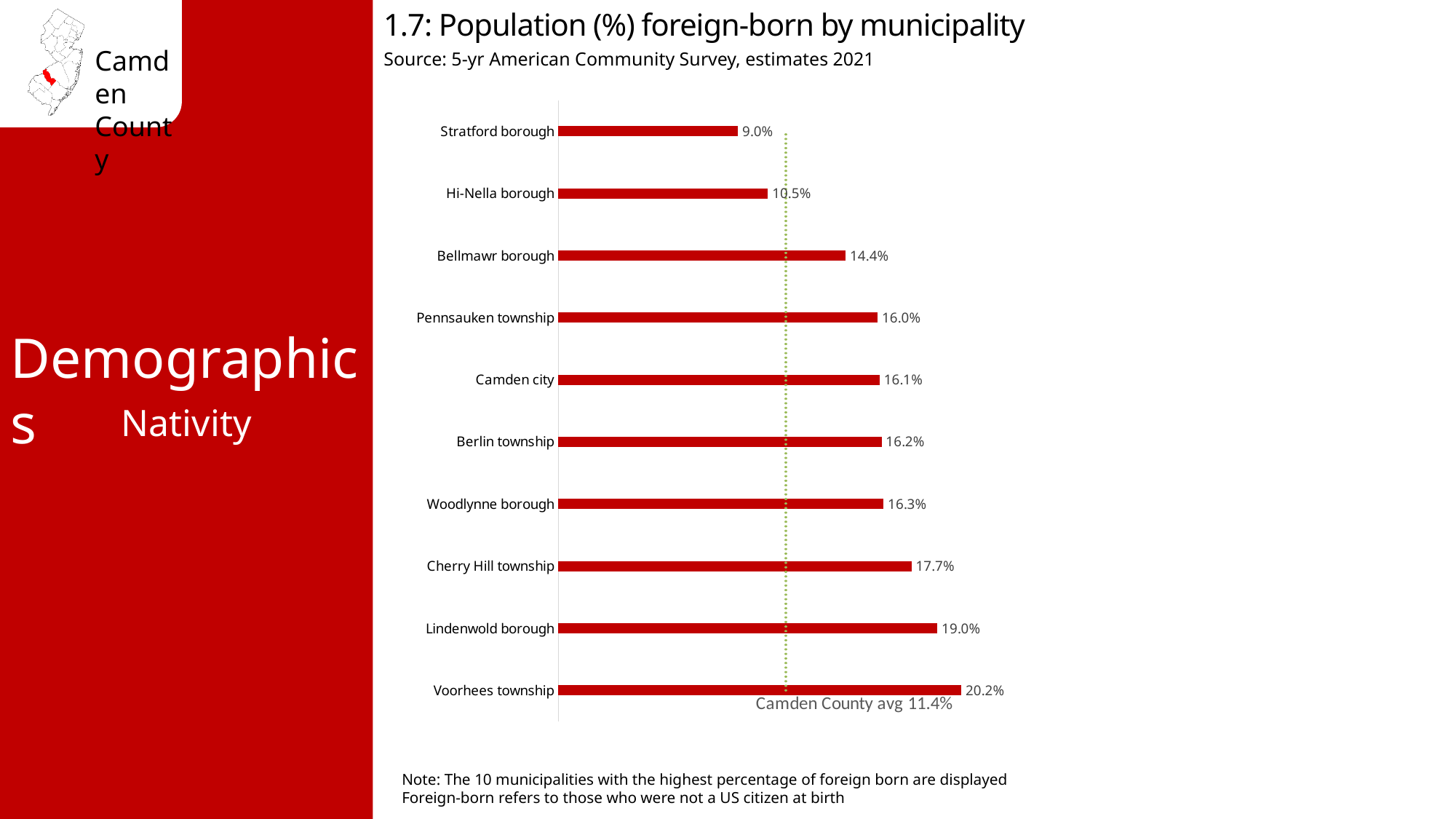
What is the foreign-born population percentage for Voorhees township? 20.2% How many municipalities are shown in the chart? 10 What is the source of the data shown in the chart? 5-yr American Community Survey, estimates 2021 What is the difference in foreign-born percentage between Voorhees township and Stratford borough? 11.2% What is the Camden County average foreign-born percentage indicated by the dotted line? 11.4% Which municipality has the lowest foreign-born population percentage? Stratford borough Which has a higher foreign-born percentage, Hi-Nella borough or Bellmawr borough? Bellmawr borough What type of chart is used to show the foreign-born population by municipality? Bar chart What is the difference in foreign-born percentage between Lindenwold borough and Cherry Hill township? 1.3% What is the foreign-born population percentage for Bellmawr borough? 14.4% What is the foreign-born population percentage for Camden city? 16.1% Which municipality has the highest foreign-born population percentage? Voorhees township